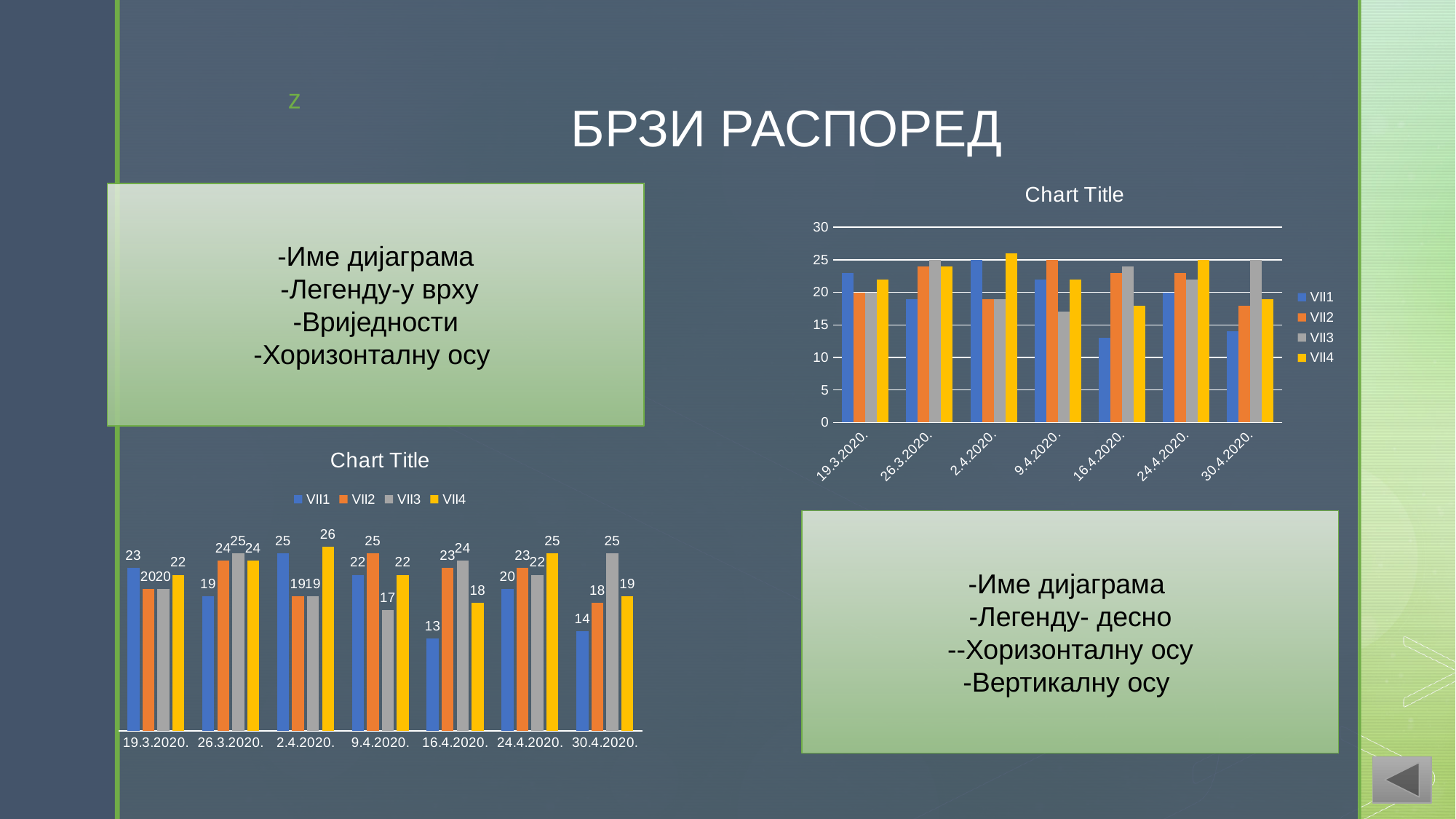
How many dates are shown on the x axis of the top-right chart? 7 How many series does the legend of the top-right chart list? 4 In the top-right chart, is the value for VII4 on 2.4.2020. greater or less than 25? greater What type of chart is the bottom-left chart? Bar chart In the bottom-left chart, what is the difference between VII2 and VII1 on 16.4.2020.? 10 In the bottom-left chart, what is the value for VII1 on 19.3.2020.? 23 In the bottom-left chart, which is larger on 24.4.2020.: VII4 or VII1? VII4 In the bottom-left chart, which series has the highest value on 30.4.2020.? VII3 In the bottom-left chart, what is the value for VII4 on 2.4.2020.? 26 In the top-right chart, is the value for VII1 on 16.4.2020. greater or less than 15? less In the bottom-left chart, what is the value for VII3 on 9.4.2020.? 17 In the bottom-left chart, which date has the lowest value for VII1? 16.4.2020.